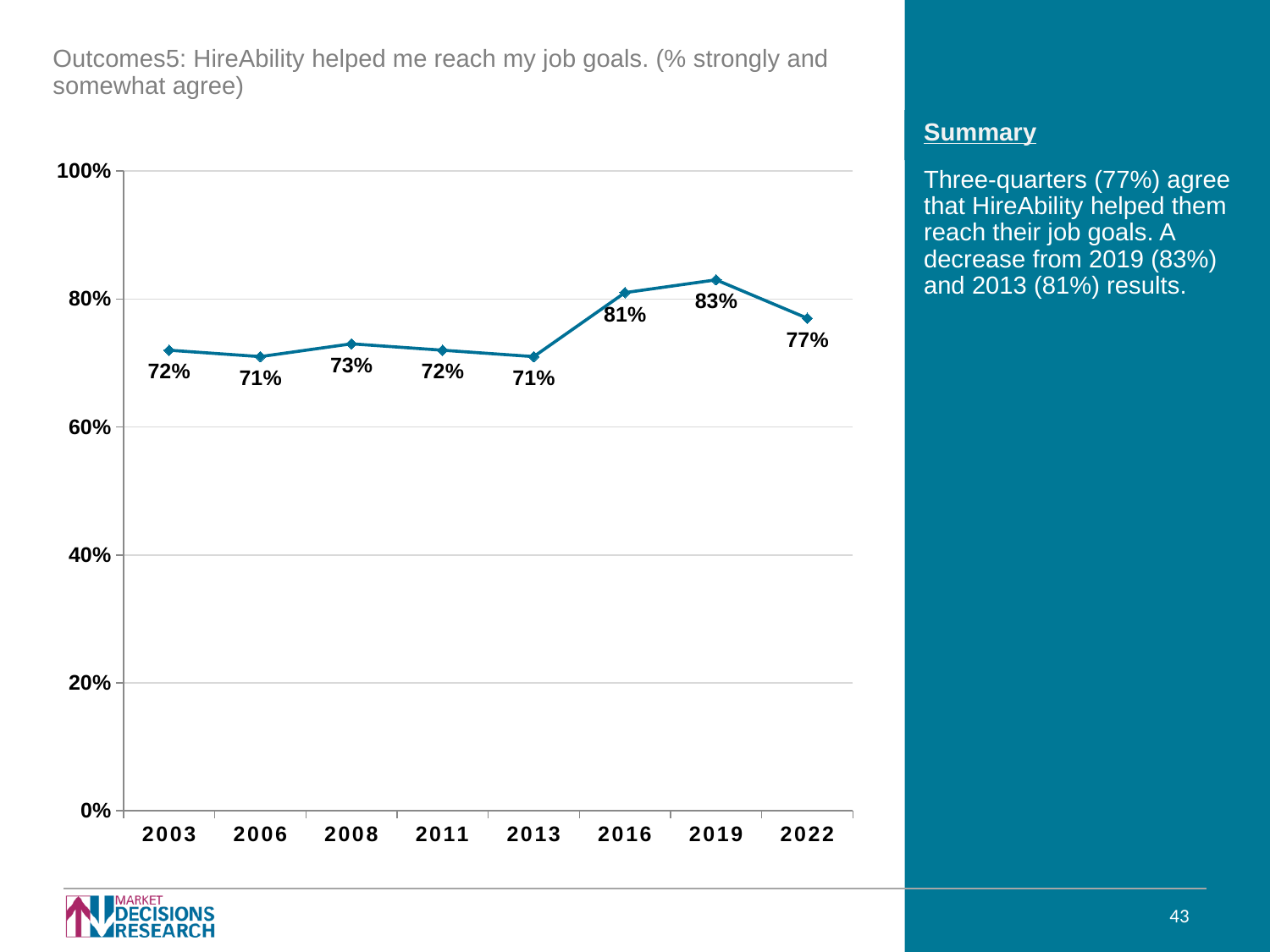
What is the difference between the 2016 value and the 2013 value? 10% How many years are plotted on the chart? 8 What is the value for 2008? 73% What kind of chart is shown on the slide? line chart Is the value for 2003 greater or less than 80%? less Does the value rise or fall from 2019 to 2022? fall Which is larger, the value for 2016 or the value for 2022? 2016 What is the value for 2013? 71% Is the value for 2019 greater or less than 80%? greater What is the difference between the 2019 value and the 2022 value? 6% What is the value for 2022? 77% Which year has the highest value? 2019